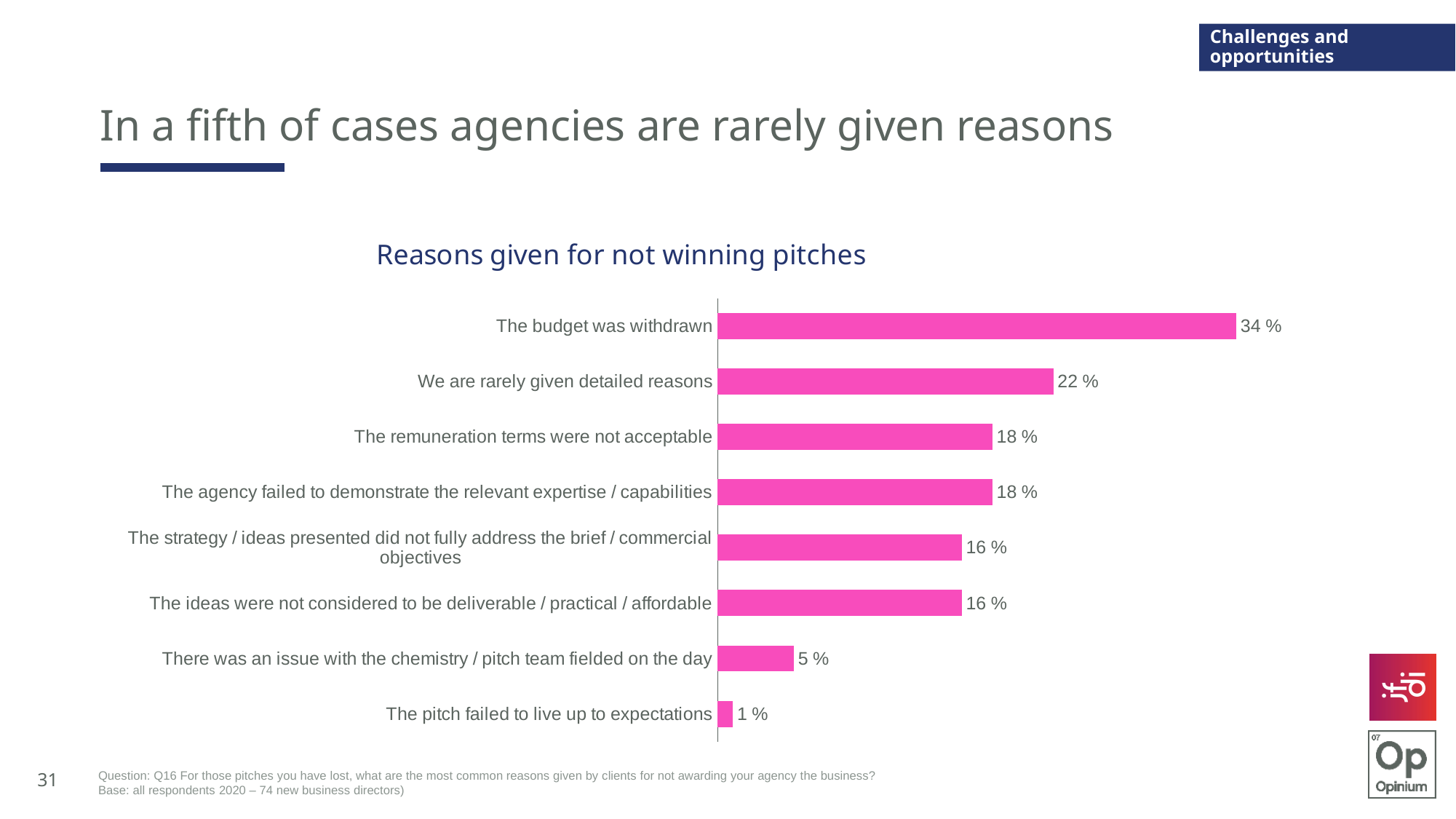
What is the value for 'We are rarely given detailed reasons'? 22 % What is the difference between 'There was an issue with the chemistry / pitch team fielded on the day' and 'The pitch failed to live up to expectations'? 4 % What is the value for 'There was an issue with the chemistry / pitch team fielded on the day'? 5 % What is the difference between 'The budget was withdrawn' and 'We are rarely given detailed reasons'? 12 % What kind of chart is shown on the slide? Bar chart What is the value for 'The remuneration terms were not acceptable'? 18 % How many reasons are shown in the chart? 8 Which reason has the lowest value? The pitch failed to live up to expectations Which is larger: 'The remuneration terms were not acceptable' or 'The ideas were not considered to be deliverable / practical / affordable'? The remuneration terms were not acceptable What is the title of the chart? Reasons given for not winning pitches Which reason has the highest value? The budget was withdrawn What is the value for 'The budget was withdrawn'? 34 %